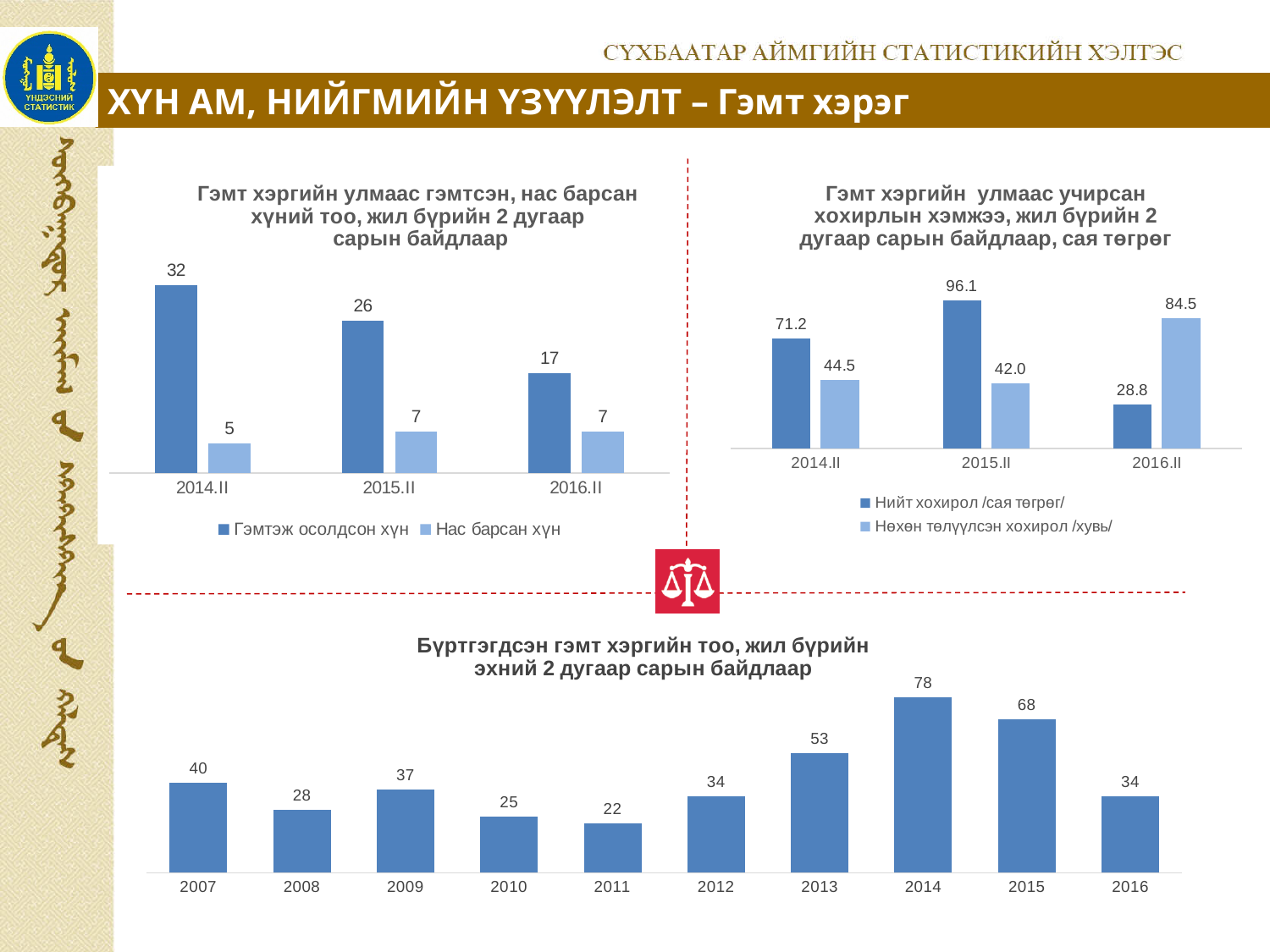
In the bottom chart (Бүртгэгдсэн гэмт хэргийн тоо), which year has the highest value? 2014 In the bottom chart (Бүртгэгдсэн гэмт хэргийн тоо), which year has the lowest value? 2011 In the top-right chart (Гэмт хэргийн улмаас учирсан хохирлын хэмжээ), which is larger in 2016.II: Нийт хохирол /сая төгрөг/ or Нөхөн төлүүлсэн хохирол /хувь/? Нөхөн төлүүлсэн хохирол /хувь/ In the top-right chart (Гэмт хэргийн улмаас учирсан хохирлын хэмжээ), what is the difference between Нийт хохирол /сая төгрөг/ in 2015.II and 2016.II? 67.3 In the top-right chart (Гэмт хэргийн улмаас учирсан хохирлын хэмжээ), what is the value for Нийт хохирол /сая төгрөг/ in 2015.II? 96.1 In the bottom chart (Бүртгэгдсэн гэмт хэргийн тоо), what kind of chart is it? bar chart In the bottom chart (Бүртгэгдсэн гэмт хэргийн тоо), what is the difference between the values for 2014 and 2015? 10 In the bottom chart (Бүртгэгдсэн гэмт хэргийн тоо), what is the value for 2014? 78 In the top-left chart (Гэмт хэргийн улмаас гэмтсэн, нас барсан хүний тоо), what is the value for Гэмтэж осолдсон хүн in 2015.II? 26 In the top-left chart (Гэмт хэргийн улмаас гэмтсэн, нас барсан хүний тоо), how many series does the legend list? 2 In the top-left chart (Гэмт хэргийн улмаас гэмтсэн, нас барсан хүний тоо), do the values for Гэмтэж осолдсон хүн rise or fall from 2014.II to 2016.II? fall In the bottom chart (Бүртгэгдсэн гэмт хэргийн тоо), how many years are shown on the x axis? 10